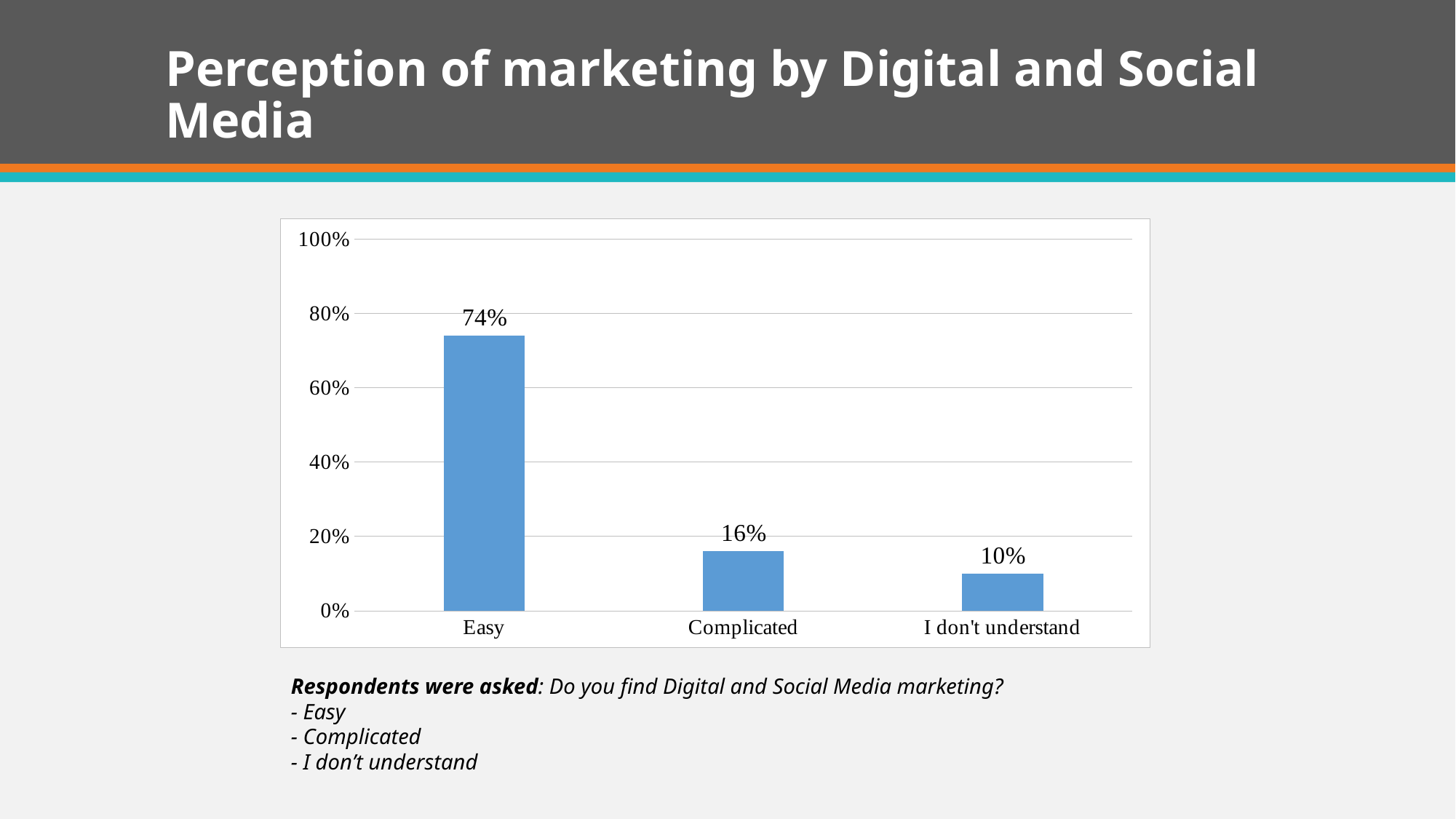
What percentage of respondents find Digital and Social Media marketing easy? 74% What is the difference between the 'Complicated' and 'I don't understand' values? 6% What is the value shown for the 'I don't understand' category? 10% What is the difference between the 'Easy' and 'Complicated' values? 58% What kind of chart is shown on the slide? Bar chart Is the value for 'Easy' greater or less than 60%? greater Do the values rise or fall from left to right along the x axis? Fall Which is larger, the value for 'Complicated' or the value for 'I don't understand'? Complicated Which category has the lowest value? I don't understand What is the value shown for the 'Complicated' category? 16% How many categories are shown on the x axis? 3 Which category has the highest value? Easy